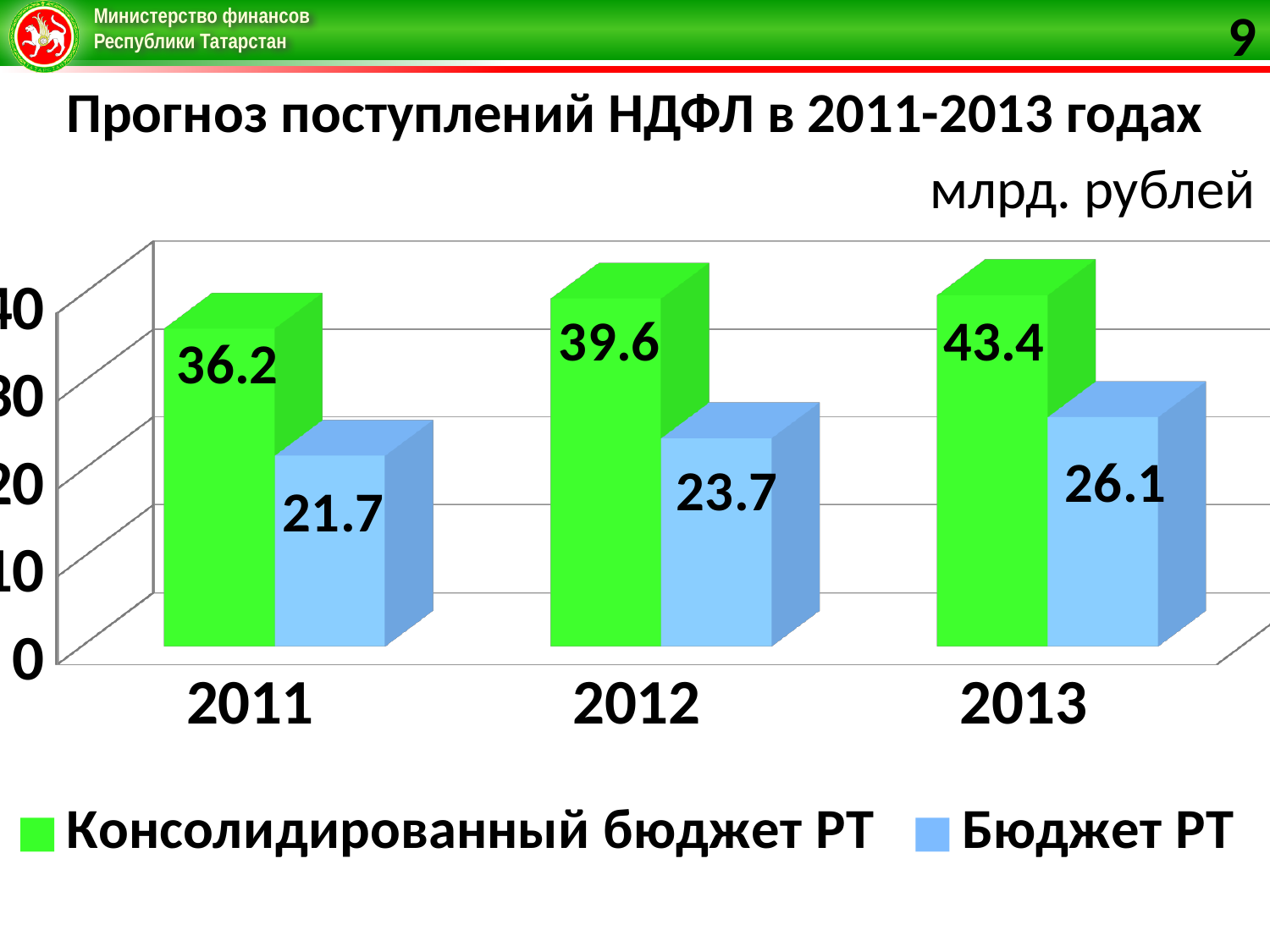
What is the value for Бюджет РТ in 2013? 26.1 Which is larger: Бюджет РТ in 2013 or Консолидированный бюджет РТ in 2011? Консолидированный бюджет РТ in 2011 What is the difference between the Консолидированный бюджет РТ values for 2013 and 2011? 7.2 What is the value for Бюджет РТ in 2012? 23.7 What is the difference between Консолидированный бюджет РТ and Бюджет РТ in 2012? 15.9 Which year has the lowest value for Бюджет РТ? 2011 Do the values for Бюджет РТ rise or fall from 2011 to 2013? rise Which year has the highest value for Консолидированный бюджет РТ? 2013 How many years are shown on the x axis? 3 What kind of chart is shown on the slide? bar chart How many series does the legend list? 2 What is the value for Консолидированный бюджет РТ in 2011? 36.2